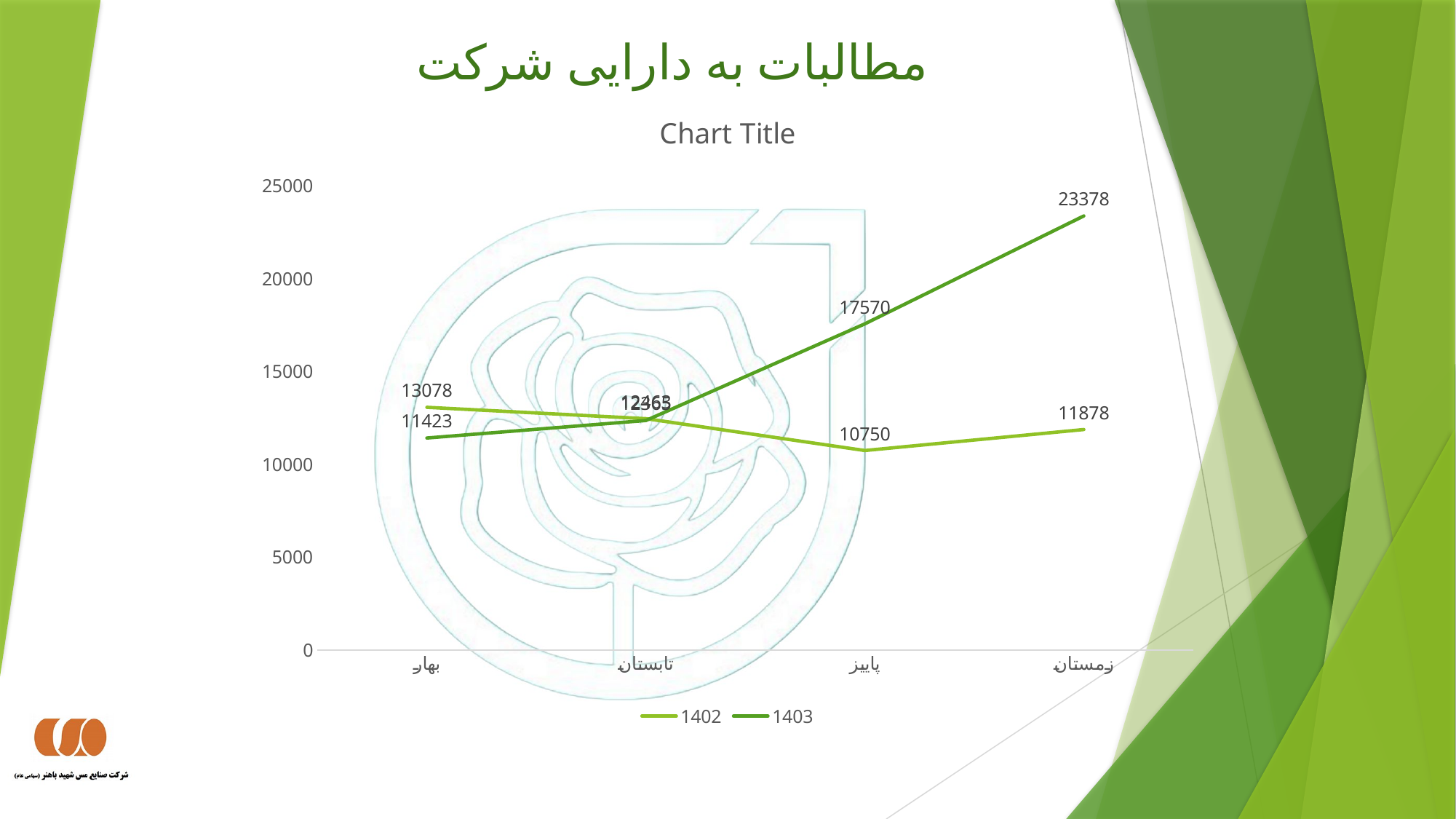
How many categories are on the x axis? 4 Is the value of the 1403 series for تابستان greater or less than 15000? less What kind of chart is shown on the slide? line chart What is the value of the 1402 series for پاییز? 10750 What is the value of the 1402 series for بهار? 13078 What is the value of the 1403 series for زمستان? 23378 What is the value of the 1403 series for پاییز? 17570 For بهار, which series has the larger value, 1402 or 1403? 1402 In which category does the 1403 series reach its highest value? زمستان What is the value of the 1403 series for بهار? 11423 What is the difference between the 1403 and 1402 values for زمستان? 11500 How many series does the legend list? 2